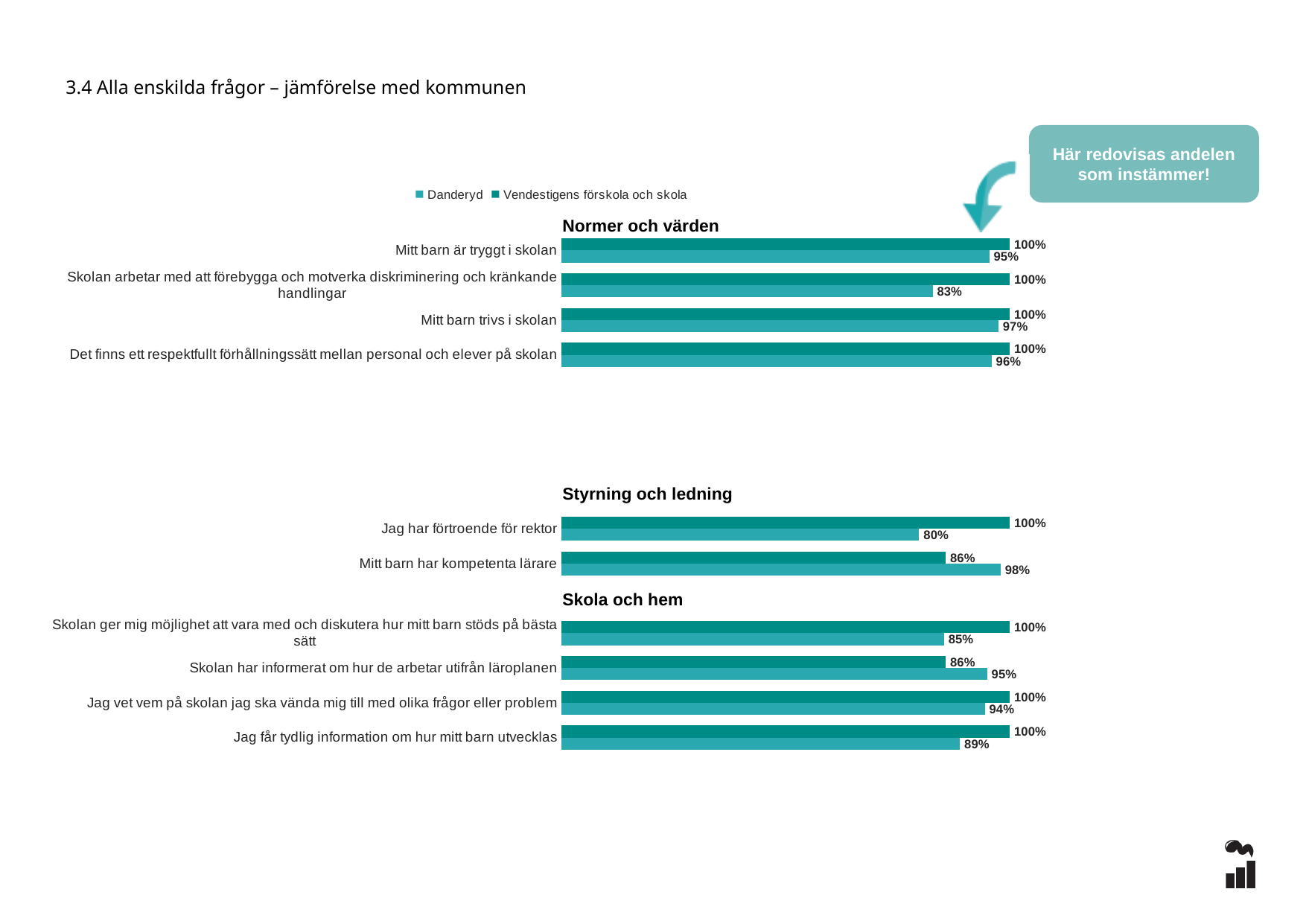
What type of chart is used on this slide? Bar chart In the 'Skola och hem' chart, what is the Danderyd value for 'Jag får tydlig information om hur mitt barn utvecklas'? 89% In the 'Styrning och ledning' chart, what is the Vendestigens förskola och skola value for 'Mitt barn har kompetenta lärare'? 86% In the 'Styrning och ledning' chart, what is the difference between the Vendestigens förskola och skola value and the Danderyd value for 'Jag har förtroende för rektor'? 20 percentage points How many categories are shown in the 'Skola och hem' chart? 4 In the 'Normer och värden' chart, which category has the lowest Danderyd value? Skolan arbetar med att förebygga och motverka diskriminering och kränkande handlingar What are the two series named in the legend? Danderyd and Vendestigens förskola och skola In the 'Normer och värden' chart, what is the Danderyd value for 'Mitt barn är tryggt i skolan'? 95% How many series does the legend list? 2 How many categories are shown in the 'Styrning och ledning' chart? 2 In the 'Skola och hem' chart, which is larger for 'Skolan har informerat om hur de arbetar utifrån läroplanen': the Danderyd value or the Vendestigens förskola och skola value? Danderyd In the 'Normer och värden' chart, what is the Danderyd value for 'Skolan arbetar med att förebygga och motverka diskriminering och kränkande handlingar'? 83%